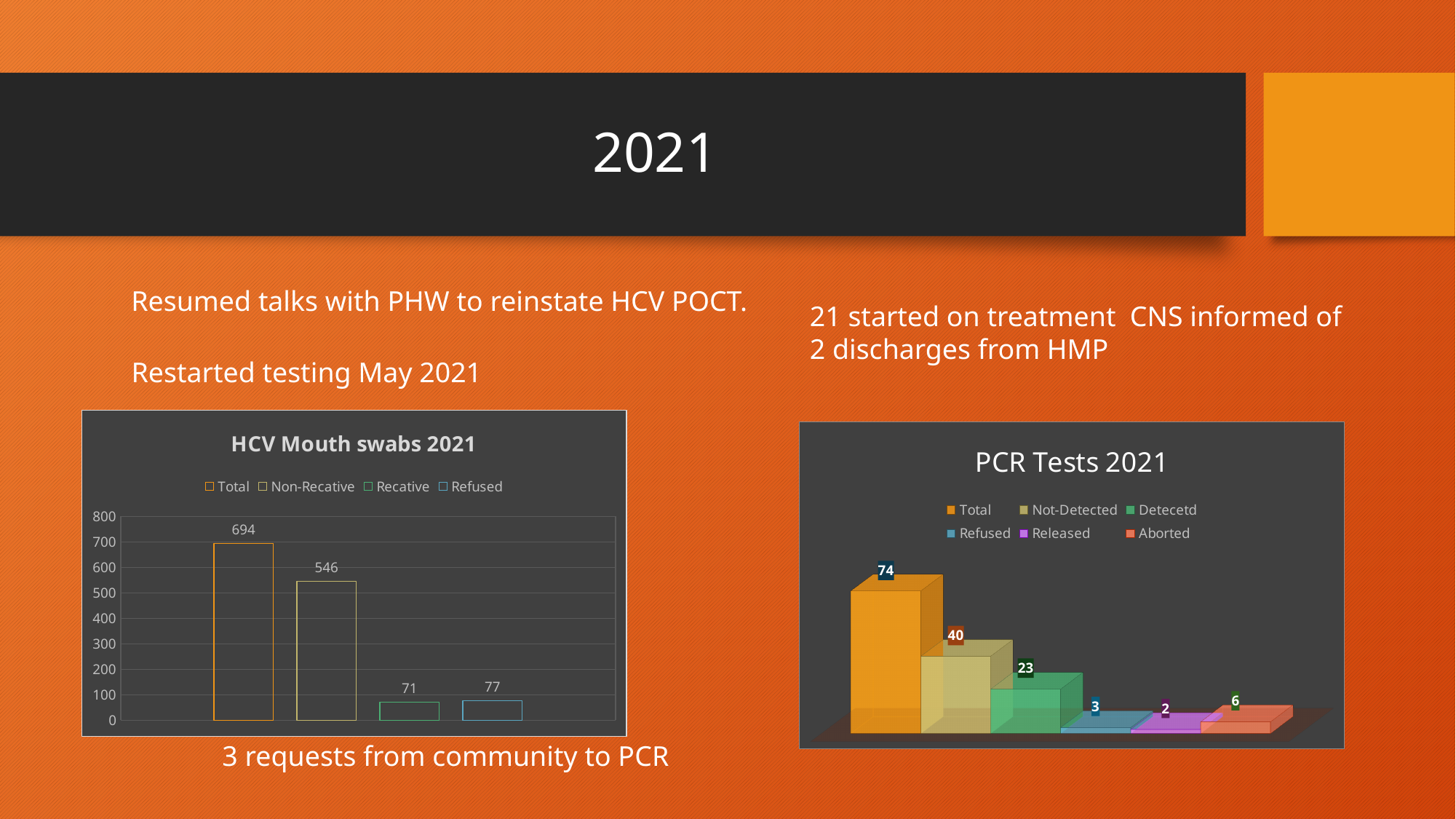
In the 'HCV Mouth swabs 2021' chart, what is the value for Refused? 77 In the 'HCV Mouth swabs 2021' chart, which series has the lowest value? Recative In the 'HCV Mouth swabs 2021' chart, what is the difference between Total and Non-Recative? 148 In the 'PCR Tests 2021' chart, what is the value for Detecetd? 23 What kind of chart is 'PCR Tests 2021'? Bar chart In the 'PCR Tests 2021' chart, which is larger, Released or Aborted? Aborted In the 'PCR Tests 2021' chart, how many series does the legend list? 6 In the 'HCV Mouth swabs 2021' chart, what is the value for Non-Recative? 546 In the 'HCV Mouth swabs 2021' chart, how many series does the legend list? 4 In the 'PCR Tests 2021' chart, what is the value for Not-Detected? 40 In the 'PCR Tests 2021' chart, which series has the highest value? Total In the 'HCV Mouth swabs 2021' chart, what is the value for Total? 694